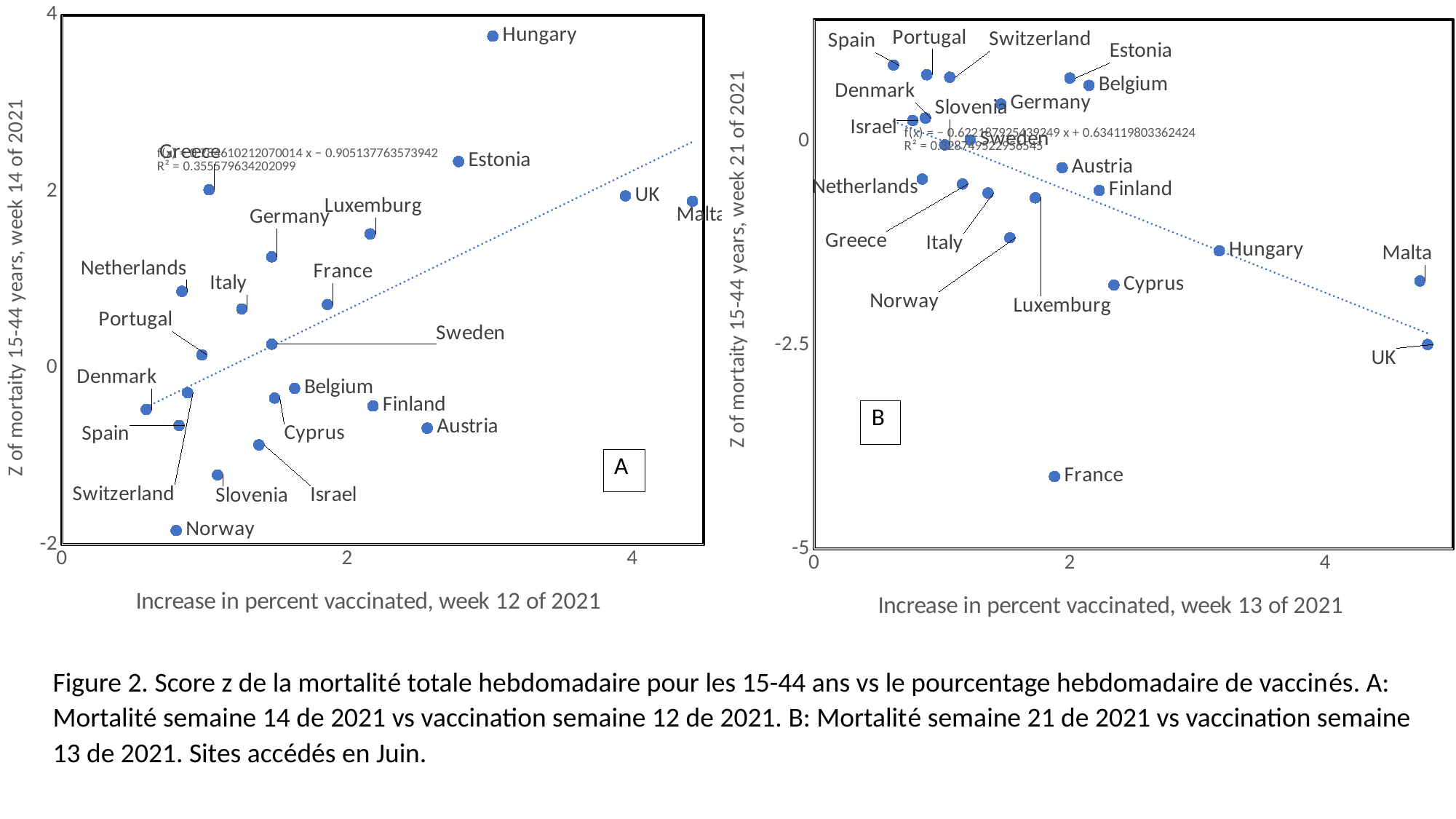
What is the x-axis title of chart B? Increase in percent vaccinated, week 13 of 2021 In chart B, is the Z of mortality for France greater or less than -2.5? less In chart A, is the Z of mortality for Hungary greater or less than 2? greater In chart A, which country has the lowest Z of mortality? Norway In chart B, is the increase in percent vaccinated for the UK greater or less than 4? greater In chart A, does the trend line rise or fall as the increase in percent vaccinated grows? rises In chart A, which has a higher Z of mortality, Hungary or Estonia? Hungary What kind of chart is chart A? scatter chart In chart A, which country has the highest Z of mortality? Hungary In chart B, which country has the lowest Z of mortality? France In chart B, does the trend line rise or fall as the increase in percent vaccinated grows? falls